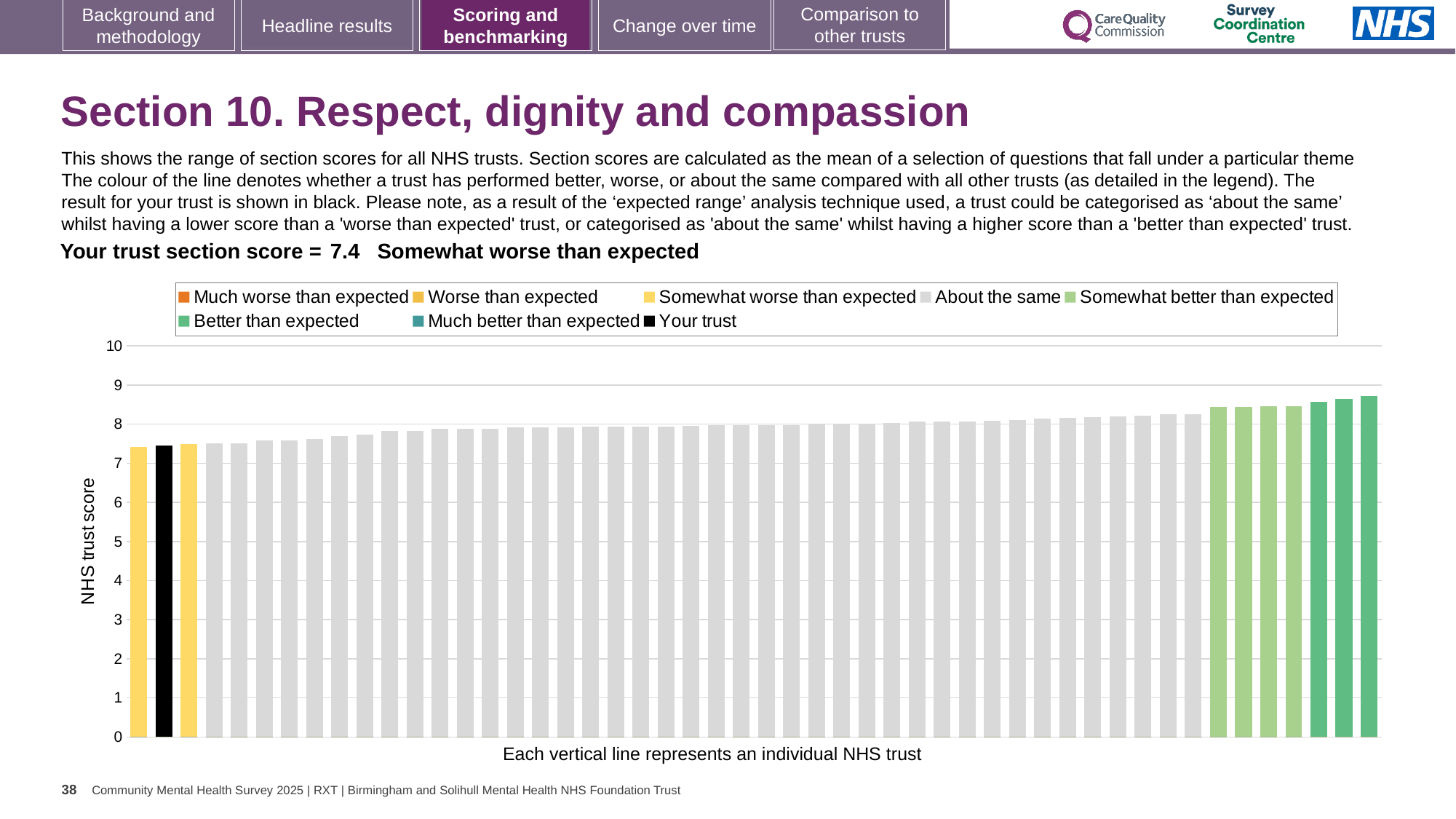
How many entries does the chart legend list? 8 What is the section score for your trust, as stated on the slide? 7.4 What kind of chart is shown on the slide? bar chart Is the value of the leftmost bar greater or less than 7? greater How many bars are coloured as 'Better than expected'? 3 Do the bar values rise or fall from left to right along the x axis? rise How many bars are coloured as 'Somewhat worse than expected'? 2 Which legend category does the tallest bar belong to? Better than expected Is the value of the tallest bar in the chart greater or less than 9? less What is the label on the vertical axis of the chart? NHS trust score Is the value of the black 'Your trust' bar greater or less than 8? less